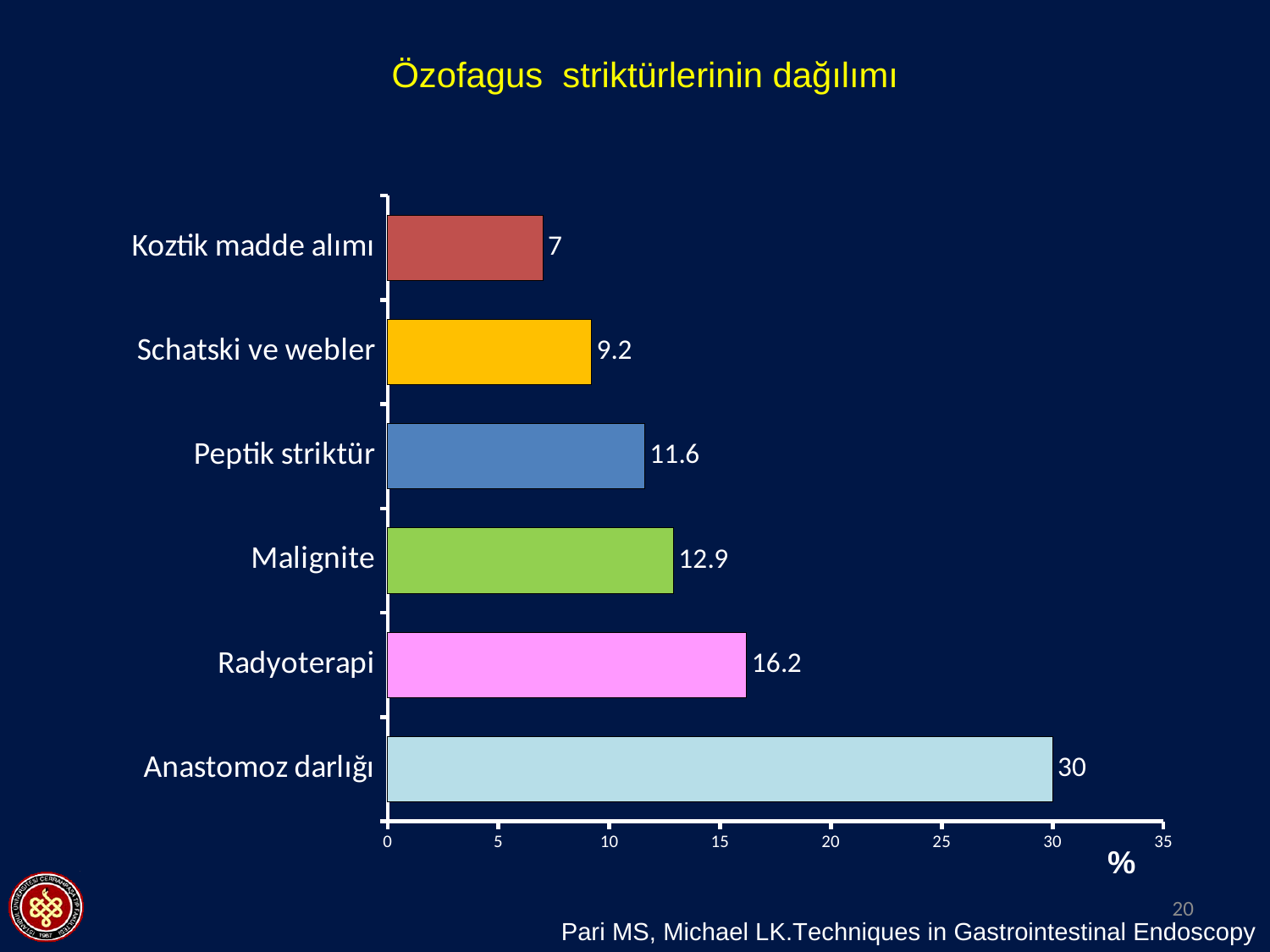
How many categories are shown in the chart? 6 Which category has the lowest value? Koztik madde alımı What is the value for Anastomoz darlığı? 30 What is the value for Peptik striktür? 11.6 What is the difference between the values for Anastomoz darlığı and Radyoterapi? 13.8 What is the difference between the values for Malignite and Koztik madde alımı? 5.9 Is the value for Radyoterapi greater or less than 15? greater What kind of chart is shown on the slide? Bar chart Which category has the highest value? Anastomoz darlığı What is the value for Schatski ve webler? 9.2 Which is larger, the value for Radyoterapi or the value for Malignite? Radyoterapi What is the title of the chart? Özofagus striktürlerinin dağılımı